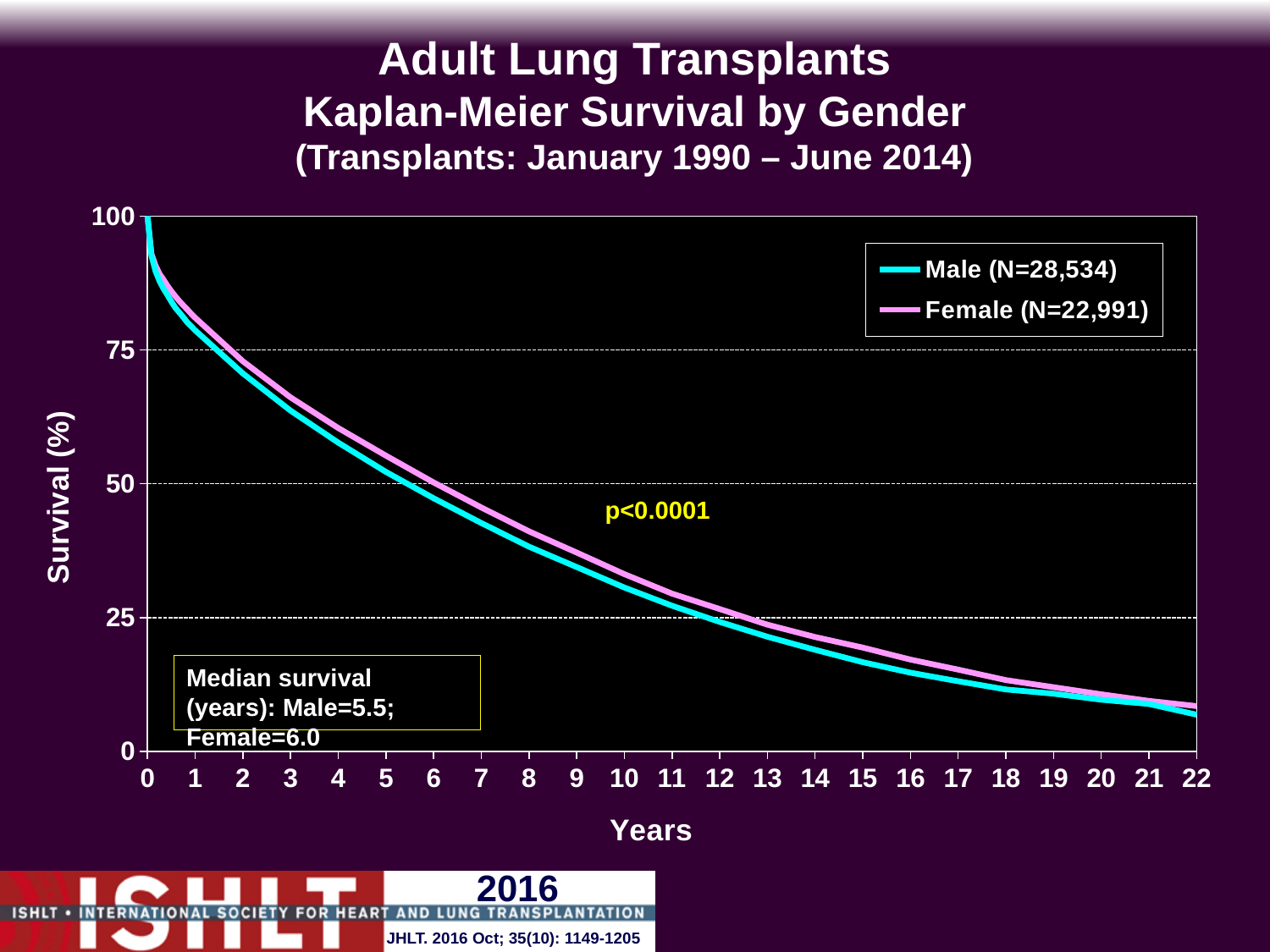
What is the N for the Female group shown in the legend? 22,991 Is the Male survival at 10 years greater or less than 50%? less How many series does the legend list? 2 What p-value is printed on the chart? p<0.0001 Is the Female survival at 20 years greater or less than 25%? less Do the survival curves rise or fall as years increase? Fall What is the difference in median survival (years) between females and males? 0.5 What is the median survival in years for females? 6.0 What kind of chart is shown on the slide? Line chart Which group has the longer median survival, Male or Female? Female What is the N for the Male group shown in the legend? 28,534 What is the median survival in years for males? 5.5